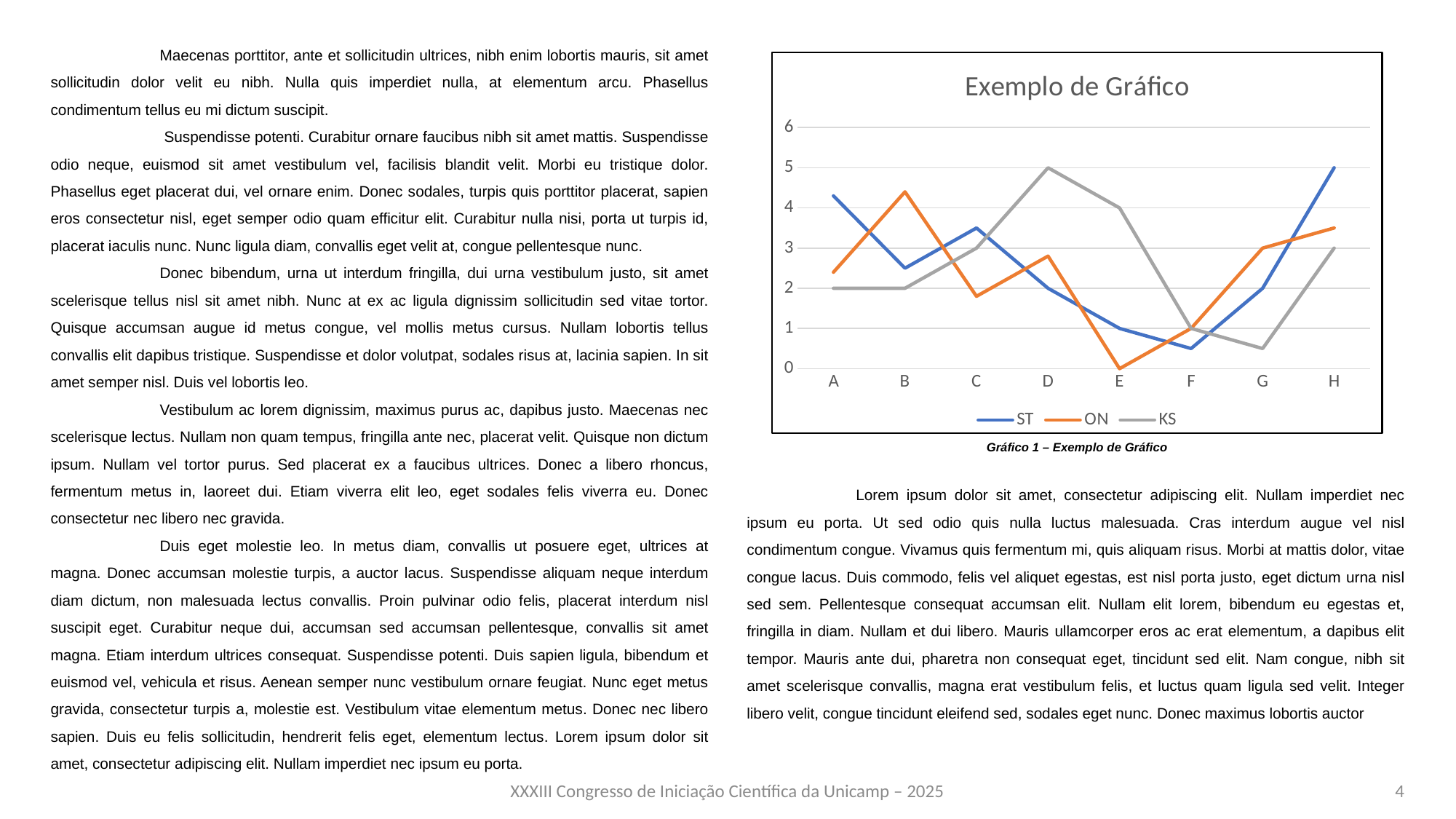
What is the title of the chart? Exemplo de Gráfico Does the ST series rise or fall from E to H? rise What is the value of the ON series at E? 0 What is the value of the KS series at D? 5 Is the value of the ON series at B greater or less than 4? greater What kind of chart is shown on the slide? line chart Is the value of the ST series at A greater or less than 4? greater How many categories are shown on the x axis of the chart? 8 At which category does the ON series reach its lowest value? E At which category does the KS series reach its highest value? D How many series does the legend of the chart list? 3 At category D, which series has the larger value, KS or ST? KS